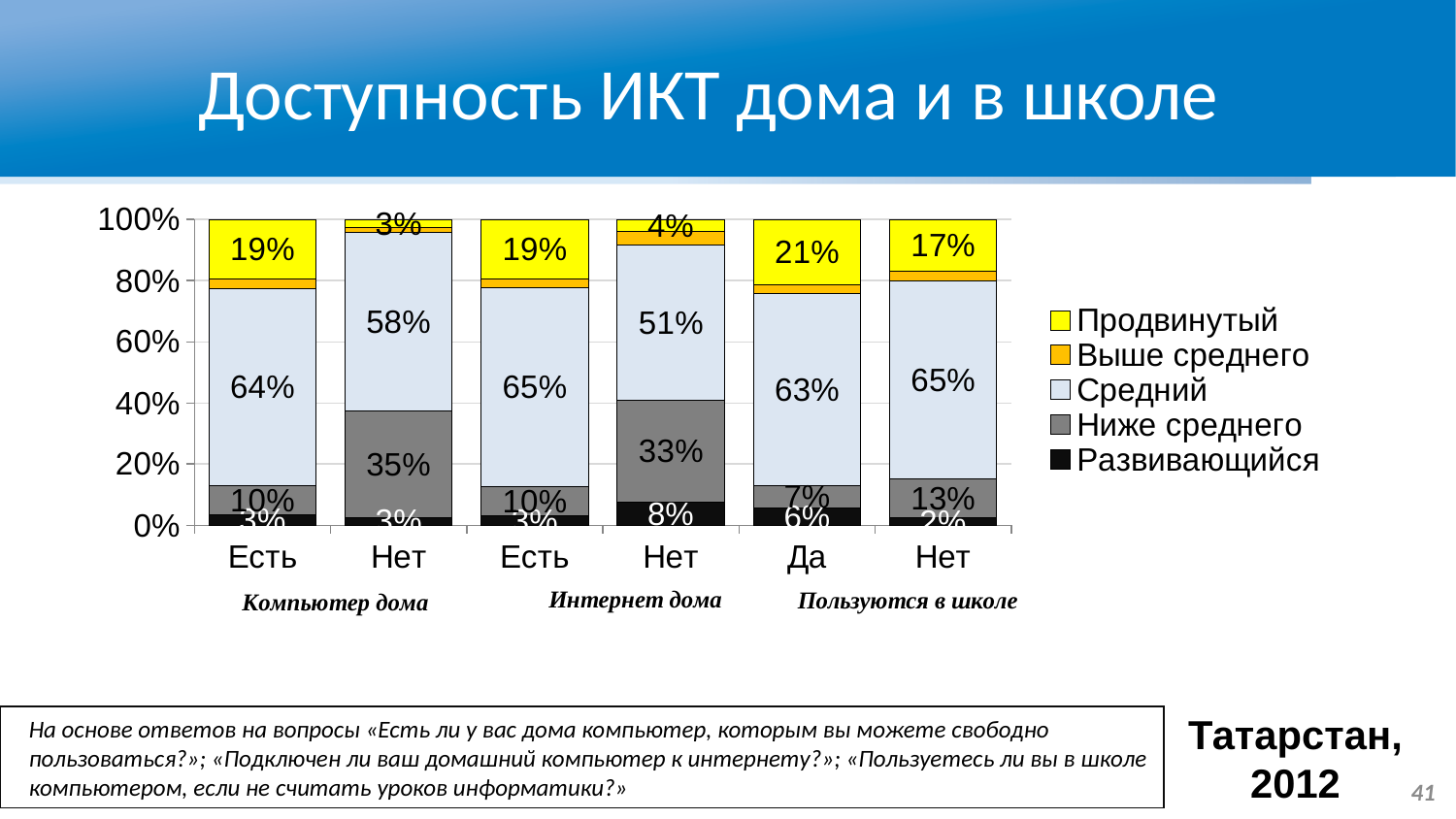
What is the difference between the Средний share for 'Есть' and 'Нет' under Компьютер дома? 6% How many bars are plotted in the chart? 6 What is the share of Средний for the 'Нет' bar under Компьютер дома? 58% What is the share of Ниже среднего for the 'Нет' bar under Интернет дома? 33% Which bar has the highest share of Ниже среднего? Нет (Компьютер дома) How many series does the legend list? 5 Which is larger: the Продвинутый share for 'Да' or for 'Нет' under Пользуются в школе? Да What kind of chart is shown on the slide? stacked bar chart What is the share of Продвинутый for the 'Да' bar under Пользуются в школе? 21% What is the share of Развивающийся for the 'Нет' bar under Интернет дома? 8% Which legend entry is shown in yellow? Продвинутый Which bar has the lowest share of Продвинутый? Нет (Компьютер дома)